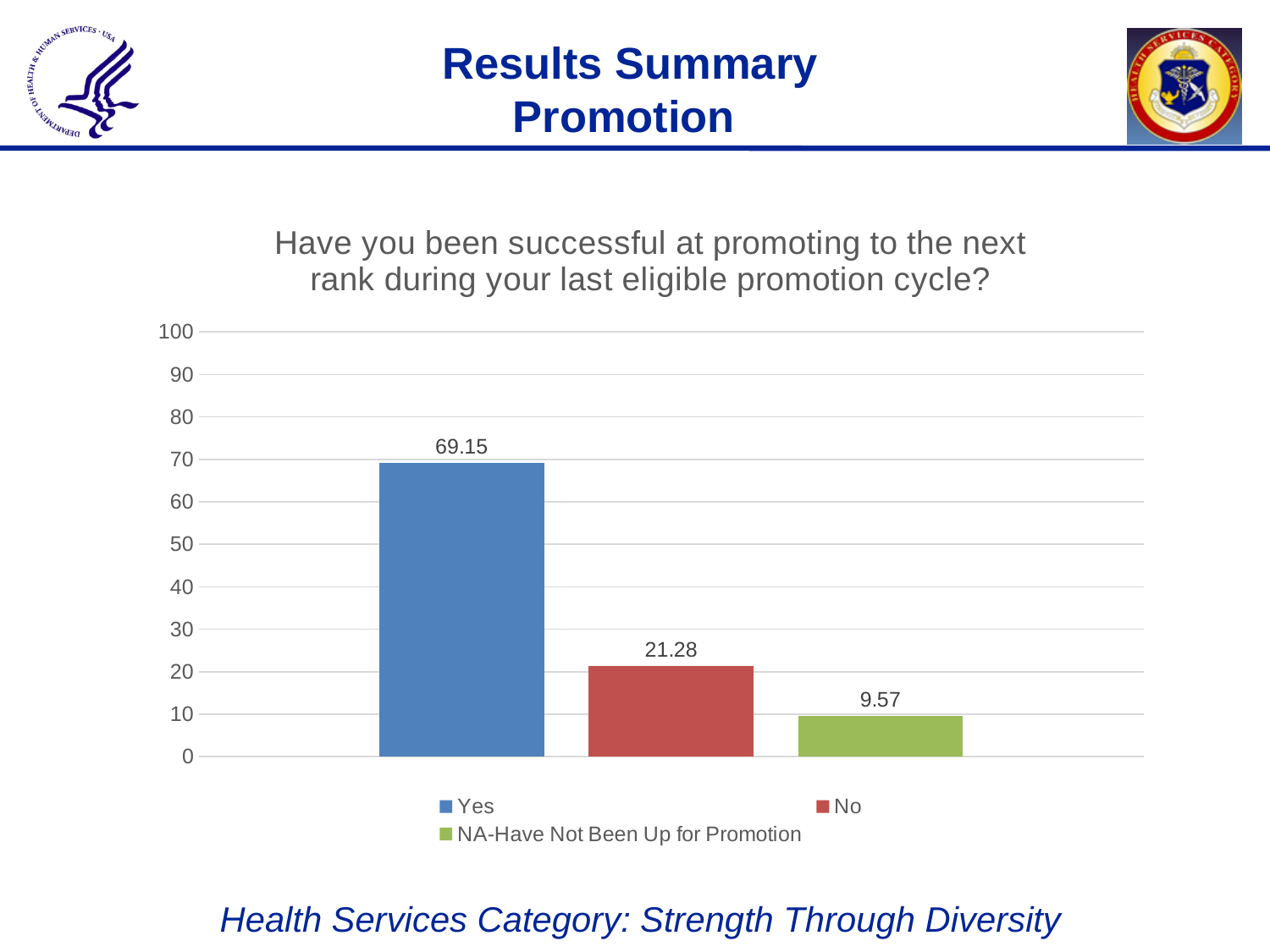
Which response has the lowest value? NA-Have Not Been Up for Promotion Is the value for Yes greater or less than 60? greater Which response has the highest value? Yes What question does the chart title ask? Have you been successful at promoting to the next rank during your last eligible promotion cycle? What is the value for NA-Have Not Been Up for Promotion? 9.57 How many bars are plotted in the chart? 3 What is the value for Yes? 69.15 How many entries does the legend list? 3 Which is larger, the value for No or the value for NA-Have Not Been Up for Promotion? No What is the difference between the values for Yes and No? 47.87 What is the value for No? 21.28 What kind of chart is shown on the slide? bar chart